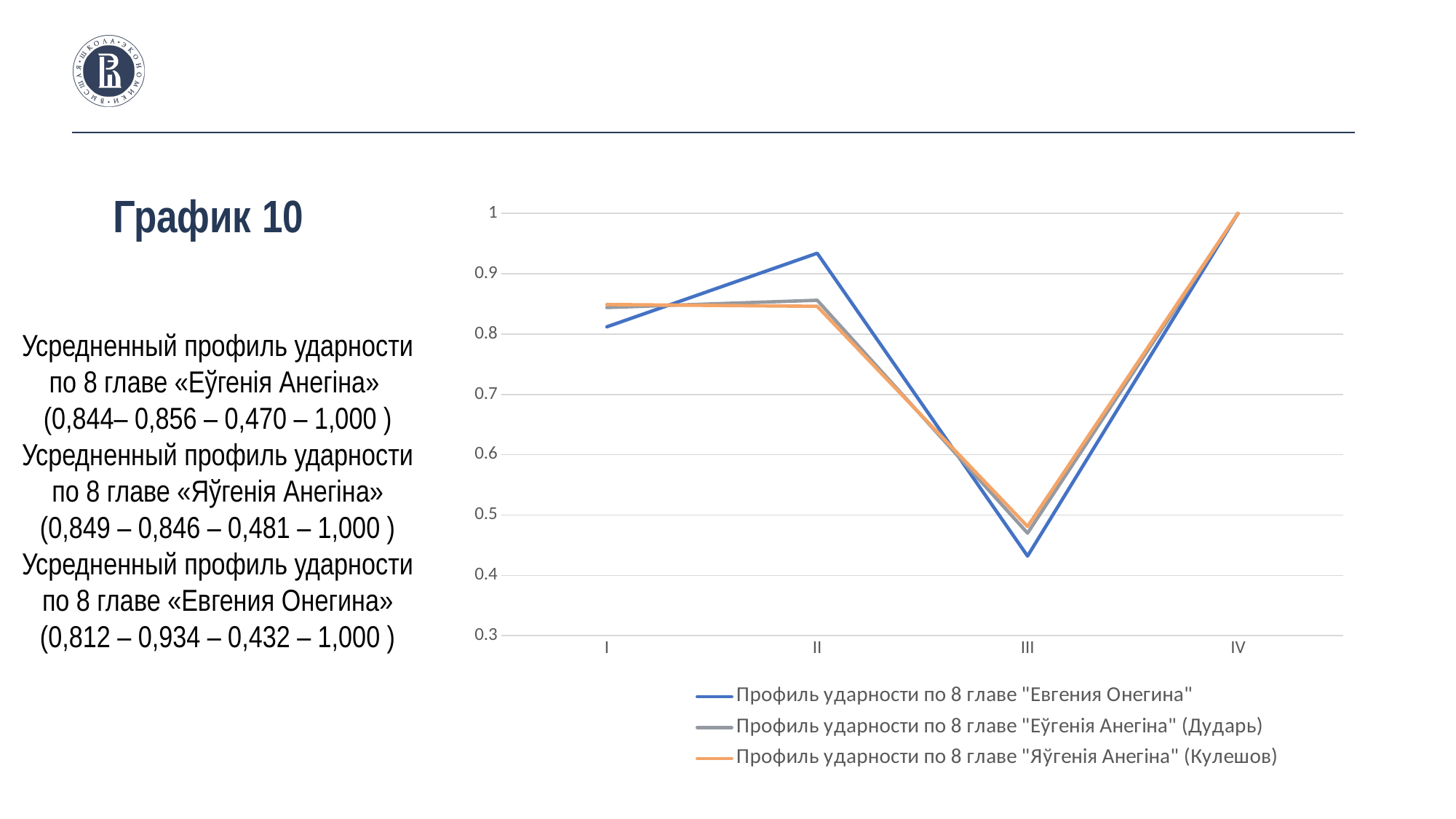
Which series reaches the highest value at point II? Профиль ударности по 8 главе "Евгения Онегина" How many series does the legend list? 3 What is the title of the slide? График 10 At point I, is the "Евгения Онегина" series higher or lower than the "Яўгенія Анегіна" (Кулешов) series? lower According to the text on the slide, what is the value of the averaged profile for «Евгения Онегина» at point II? 0,934 Is the value of the "Еўгенія Анегіна" (Дударь) series at point I greater or less than 0.8? greater What kind of chart is shown on the slide? line chart Is the value of the "Евгения Онегина" series at point III greater or less than 0.5? less How many points are plotted along the x axis for each series? 4 Is the value of the "Евгения Онегина" series at point II greater or less than 0.9? greater Which series has the lowest value at point III? Профиль ударности по 8 главе "Евгения Онегина" Do the values of all series rise or fall from point III to point IV? rise